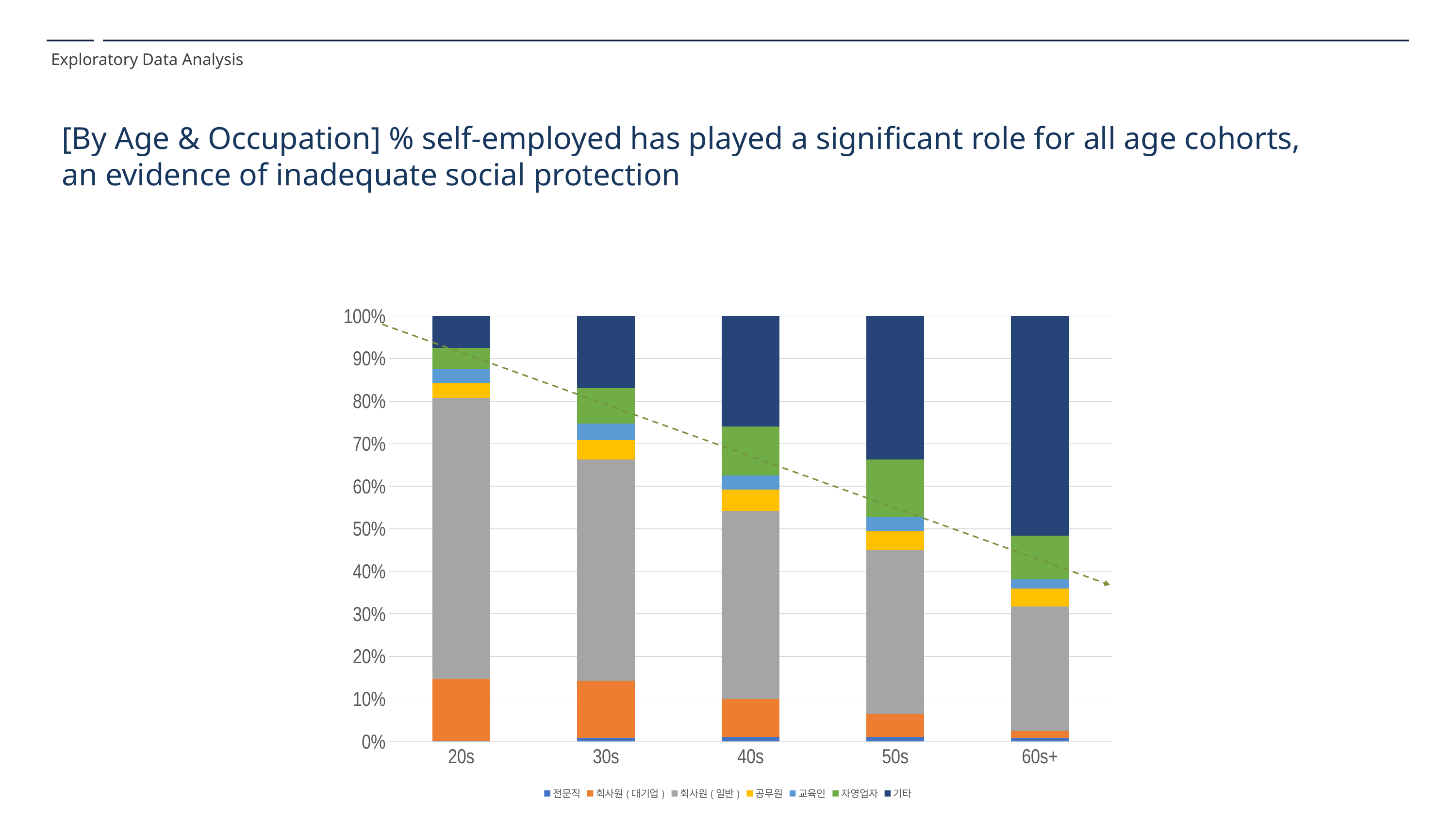
What kind of chart is shown on the slide? Stacked bar chart Is the 기타 share larger for the 60s+ cohort or the 20s cohort? 60s+ How many series does the chart's legend list? 7 Is the 회사원 ( 일반 ) share for the 20s cohort greater or less than 60%? greater How many age cohorts are shown on the x axis of the chart? 5 Does the 기타 share rise or fall as the age cohort increases from 20s to 60s+? Rises Is the 기타 share for the 50s cohort greater or less than 30%? greater Which age cohort has the largest 기타 share in the chart? 60s+ Is the 기타 share for the 20s cohort greater or less than 10%? less What is the last entry listed in the chart's legend? 기타 Which age cohort has the largest 회사원 ( 일반 ) share in the chart? 20s Which age cohort has the smallest 기타 share in the chart? 20s